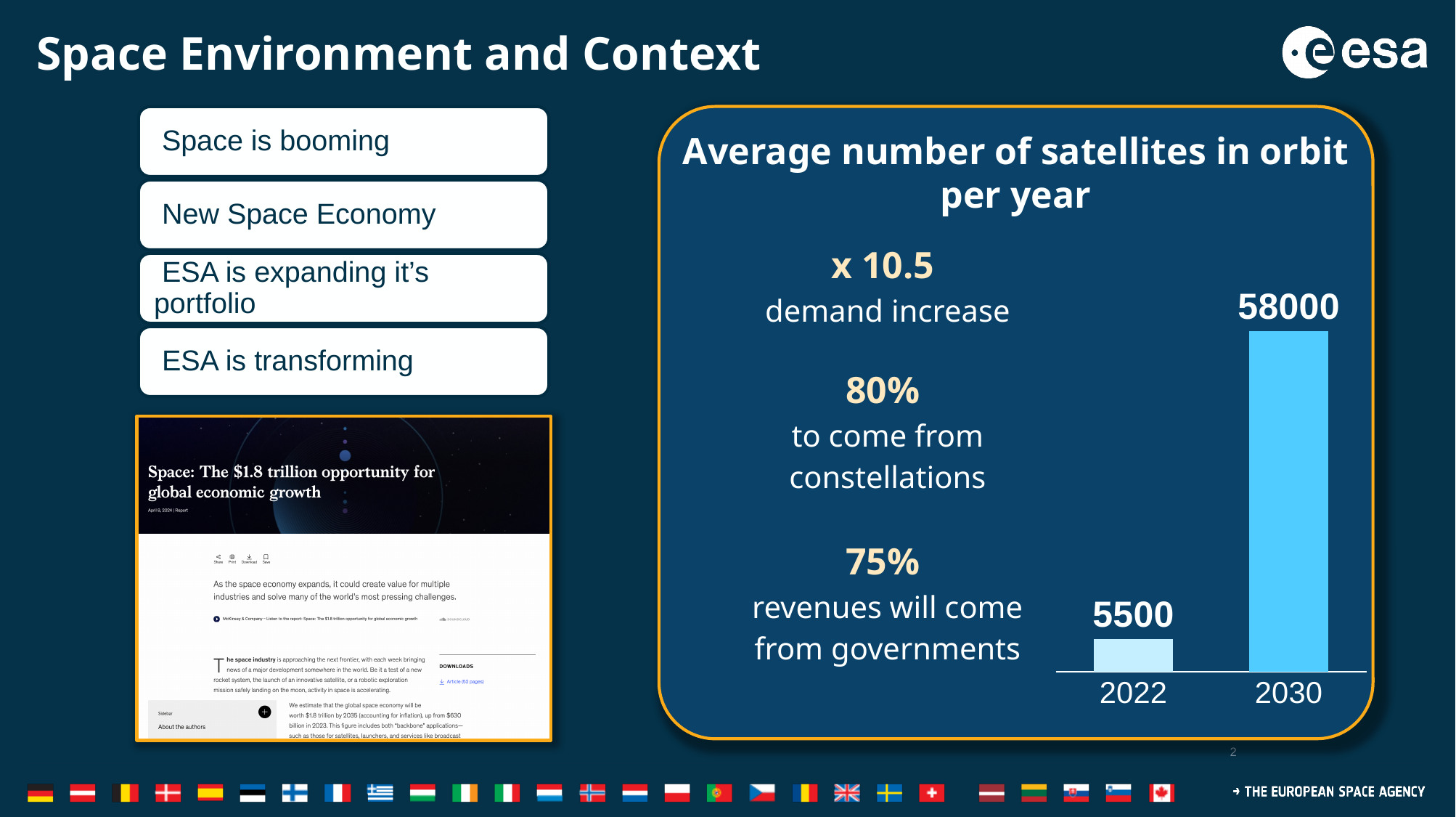
What kind of chart is shown on the slide? bar chart What is the difference between the 2030 and 2022 values in the chart? 52500 What is the value for 2022 in the chart? 5500 How many categories are shown on the x axis of the chart? 2 Which year has the higher value in the chart? 2030 Do the values rise or fall from 2022 to 2030? rise What demand increase factor is stated next to the chart? x 10.5 What is the value for 2030 in the chart? 58000 What is the title of the chart? Average number of satellites in orbit per year Which year has the lower value in the chart? 2022 Is the value for 2030 larger or smaller than the value for 2022? larger